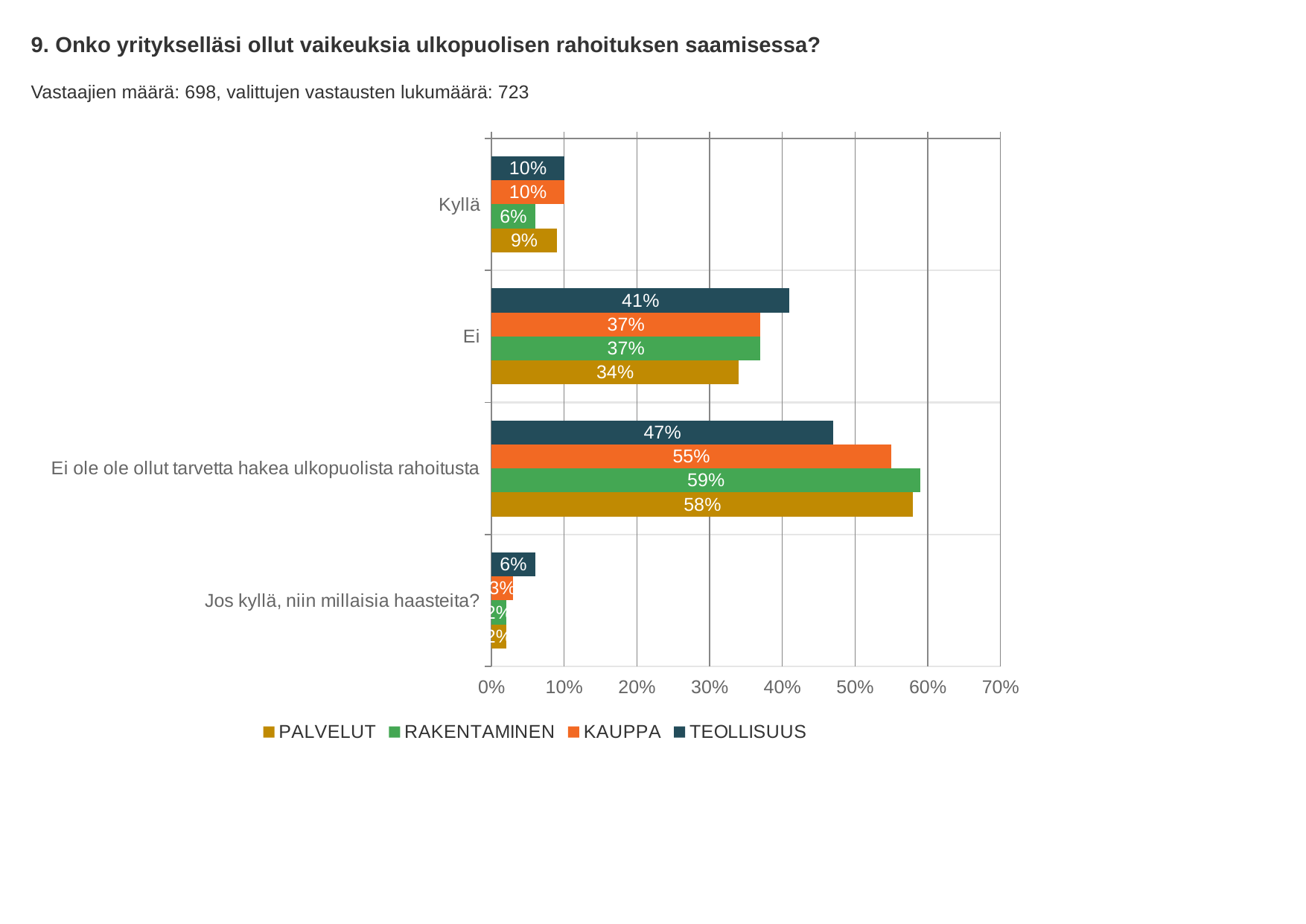
What is the value for RAKENTAMINEN in the "Kyllä" category? 6% What is the difference between the TEOLLISUUS and PALVELUT values in the "Ei" category? 7% What colour represents the TEOLLISUUS series in the legend? dark teal What kind of chart is shown on the slide? bar chart How many series does the legend list? 4 What is the value for PALVELUT in the "Ei ole ole ollut tarvetta hakea ulkopuolista rahoitusta" category? 58% What is the value for TEOLLISUUS in the "Ei" category? 41% Which series has the highest value in the "Ei ole ole ollut tarvetta hakea ulkopuolista rahoitusta" category? RAKENTAMINEN Which series has the lowest value in the "Ei" category? PALVELUT Is the value for KAUPPA in the "Ei ole ole ollut tarvetta hakea ulkopuolista rahoitusta" category greater or less than 50%? greater Which is larger in the "Kyllä" category: the value for KAUPPA or the value for RAKENTAMINEN? KAUPPA How many categories are shown on the vertical axis? 4